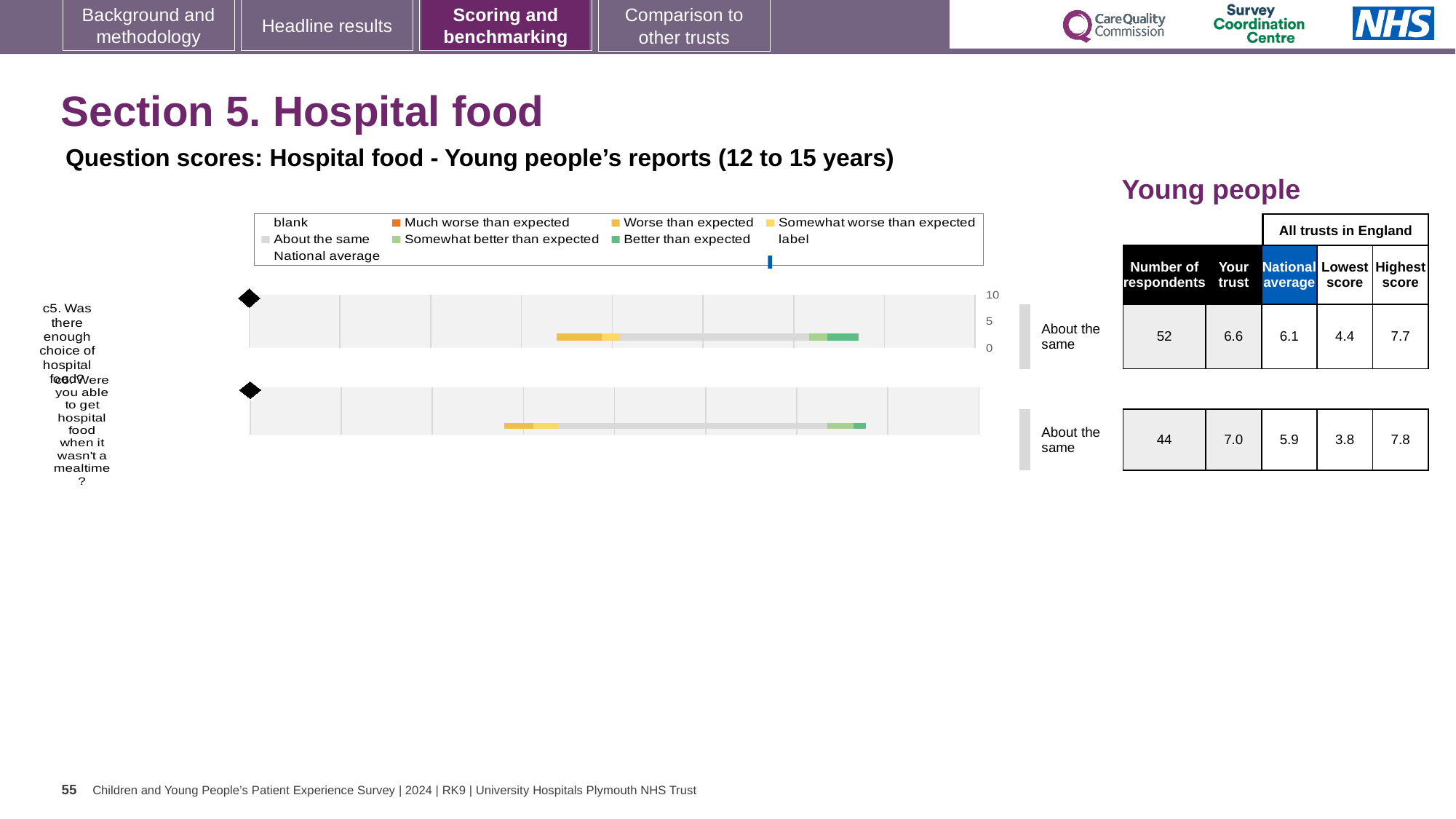
In the table beside the chart, how many respondents answered question c6? 44 What benchmark category is shown next to the bar for question c5 (enough choice of hospital food)? About the same In the chart legend, what colour represents 'Better than expected'? green In the table beside the chart, what is the national average for question c5? 6.1 What is the highest value shown on the chart's axis? 10 Which question has the higher 'Your trust' score, c5 or c6? c6 In the table beside the chart, what is the 'Your trust' score for question c6 (getting hospital food when it wasn't a mealtime)? 7.0 What is the difference between the 'Your trust' scores for c6 and c5? 0.4 How many survey questions are plotted in the hospital food chart? 2 In the table beside the chart, what is the highest score across all trusts in England for question c6? 7.8 What kind of chart is used to show the question scores for hospital food? bar chart In the table beside the chart, what is the 'Your trust' score for question c5 (enough choice of hospital food)? 6.6